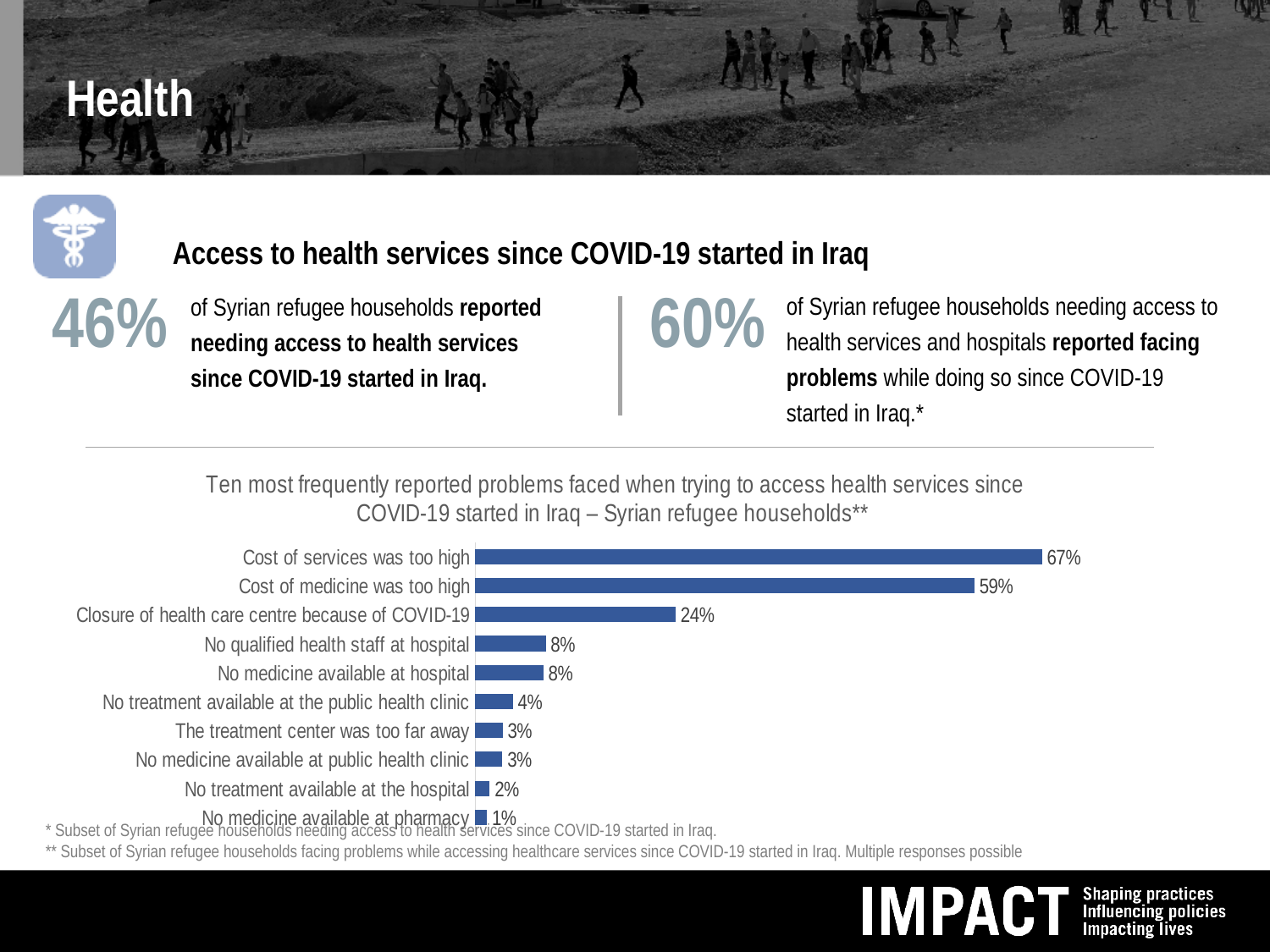
What value is shown for 'Closure of health care centre because of COVID-19'? 24% What percentage is shown for 'No treatment available at the public health clinic'? 4% What value is shown for 'The treatment center was too far away'? 3% What is the difference between 'Cost of services was too high' and 'Cost of medicine was too high'? 8% What is the title of the chart? Ten most frequently reported problems faced when trying to access health services since COVID-19 started in Iraq – Syrian refugee households** What type of chart is used to show the reported problems? Bar chart How many problems are listed in the chart? 10 What is the difference between 'Cost of medicine was too high' and 'Closure of health care centre because of COVID-19'? 35% Which problem has the lowest reported percentage? No medicine available at pharmacy What percentage of households reported that the cost of services was too high? 67% Which is larger: 'Closure of health care centre because of COVID-19' or 'No qualified health staff at hospital'? Closure of health care centre because of COVID-19 Which problem was reported most frequently? Cost of services was too high